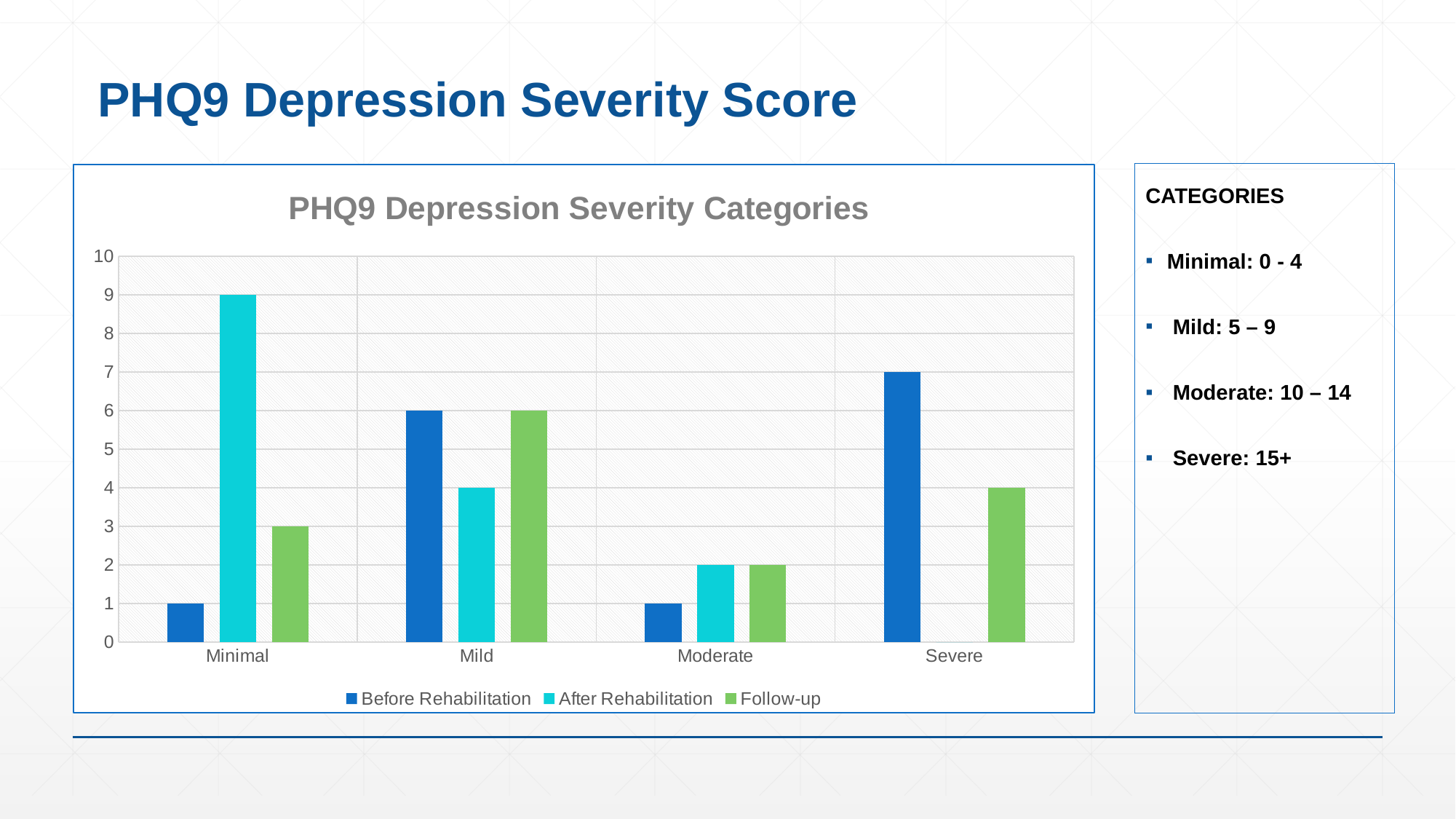
What is the Follow-up value for the Mild category? 6 Which is larger for the Severe category: the Before Rehabilitation value or the Follow-up value? Before Rehabilitation Which category has the highest After Rehabilitation value? Minimal How many series does the legend list? 3 What is the After Rehabilitation value for the Minimal category? 9 Which category has the lowest Follow-up value? Moderate How many categories are shown on the x axis? 4 What type of chart is shown on the slide? bar chart What is the difference between the After Rehabilitation and Before Rehabilitation values for the Minimal category? 8 What is the Before Rehabilitation value for the Severe category? 7 Is the After Rehabilitation value for the Minimal category greater or less than 5? greater What is the title of the chart? PHQ9 Depression Severity Categories